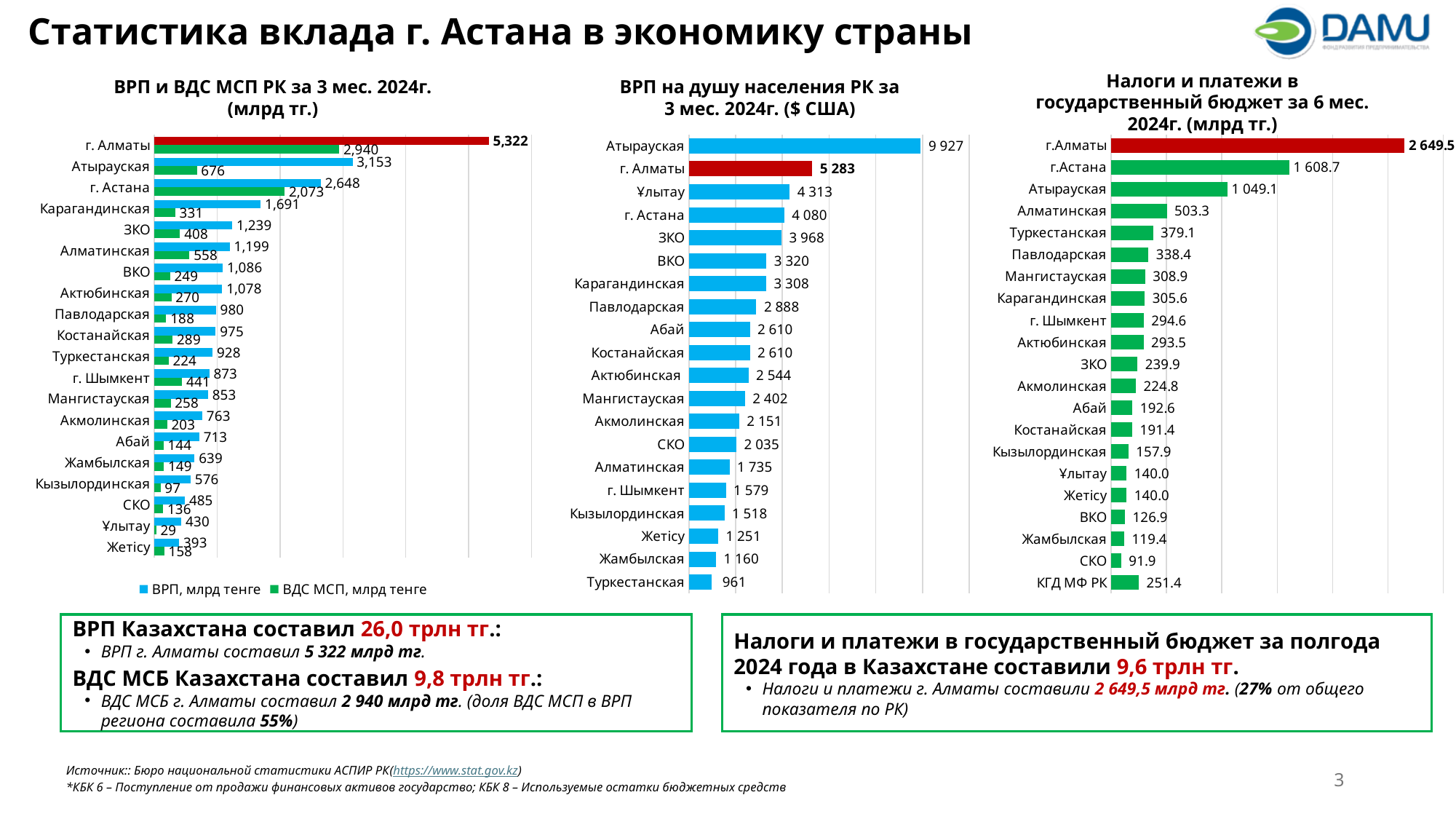
In the chart 'Налоги и платежи в государственный бюджет за 6 мес. 2024г. (млрд тг.)', what is the difference between г.Алматы and г.Астана? 1 040.8 In the chart 'ВРП на душу населения РК за 3 мес. 2024г. ($ США)', which region has the highest value? Атырауская What type of chart is 'Налоги и платежи в государственный бюджет за 6 мес. 2024г. (млрд тг.)'? Bar chart In the chart 'ВРП на душу населения РК за 3 мес. 2024г. ($ США)', how many regions are plotted? 20 In the chart 'ВРП на душу населения РК за 3 мес. 2024г. ($ США)', which region has the lowest value? Туркестанская In the chart 'ВРП и ВДС МСП РК за 3 мес. 2024г. (млрд тг.)', how many series does the legend list? 2 In the chart 'Налоги и платежи в государственный бюджет за 6 мес. 2024г. (млрд тг.)', what is the value for г.Астана? 1 608.7 In the chart 'ВРП и ВДС МСП РК за 3 мес. 2024г. (млрд тг.)', what is the ВДС МСП value for Карагандинская? 331 In the chart 'ВРП на душу населения РК за 3 мес. 2024г. ($ США)', what is the value for Ұлытау? 4 313 In the chart 'ВРП и ВДС МСП РК за 3 мес. 2024г. (млрд тг.)', what is the ВРП value for г. Астана? 2,648 In the chart 'Налоги и платежи в государственный бюджет за 6 мес. 2024г. (млрд тг.)', which is larger: Туркестанская or Павлодарская? Туркестанская In the chart 'ВРП и ВДС МСП РК за 3 мес. 2024г. (млрд тг.)', what is the difference between the ВРП and ВДС МСП values for г. Алматы? 2,382